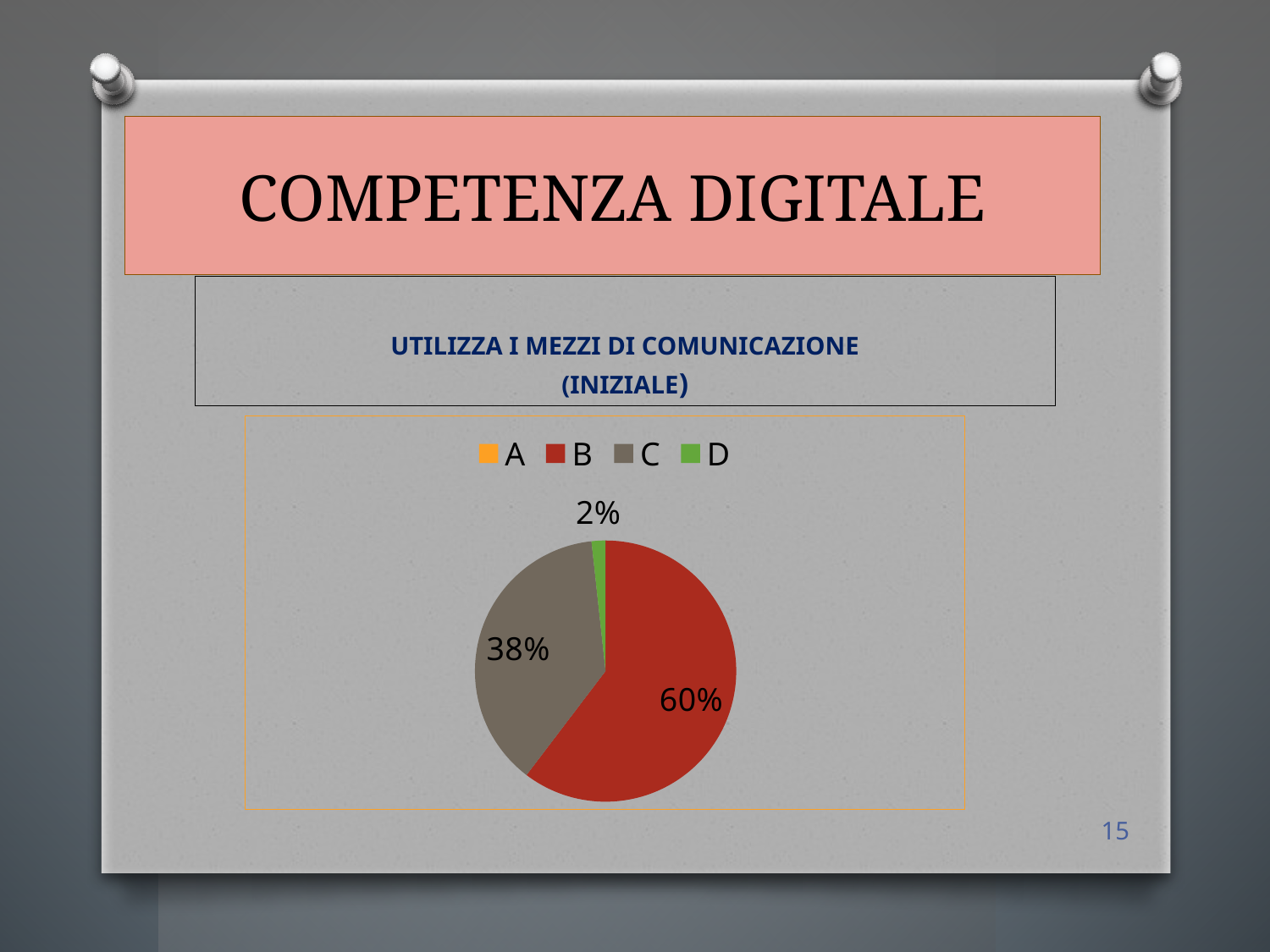
What kind of chart is shown on the slide? pie chart What is the title of the chart? UTILIZZA I MEZZI DI COMUNICAZIONE (INIZIALE) Is the share for category C greater or less than 50%? less What is the difference in percentage points between the slices for B and C? 22 What colour is the slice for category C? grey Which of the labelled slices is the smallest? D Which slice is larger, B or C? B What share of the pie does category B have? 60% What share of the pie does category D have? 2% How many categories does the legend list? 4 What share of the pie does category C have? 38% Which category has the largest slice of the pie? B